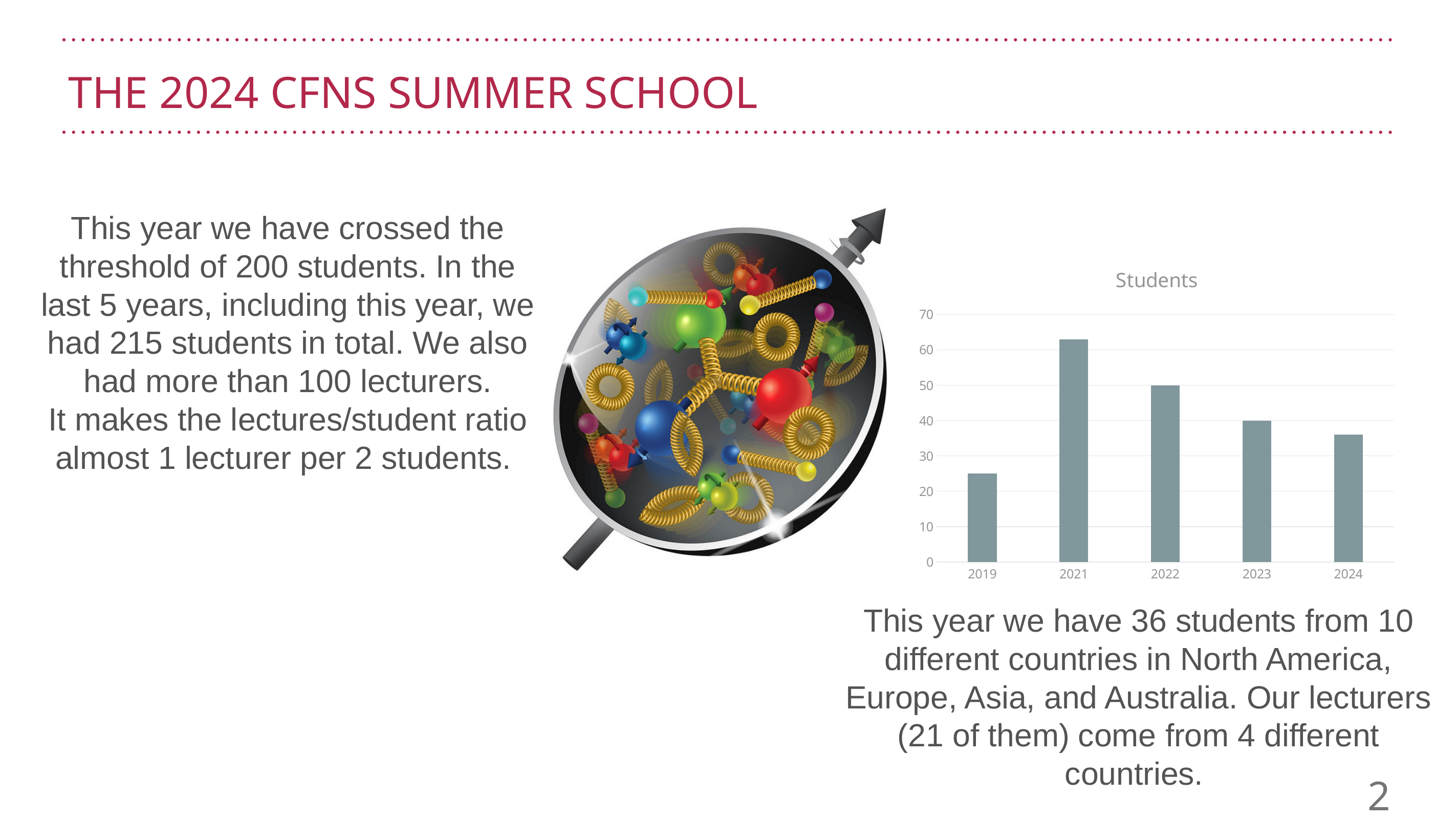
How many years are shown on the x axis of the chart? 5 What is the number of students for 2023? 40 Which year has more students, 2022 or 2024? 2022 What is the number of students for 2022? 50 What kind of chart is shown on the slide? bar chart Which year has the highest number of students? 2021 Do the values rise or fall from 2021 to 2024? fall Is the value for 2021 greater or less than 60? greater What is the difference between the number of students in 2022 and 2023? 10 Is the value for 2019 greater or less than 30? less Which year has the lowest number of students? 2019 What is the title of the chart? Students